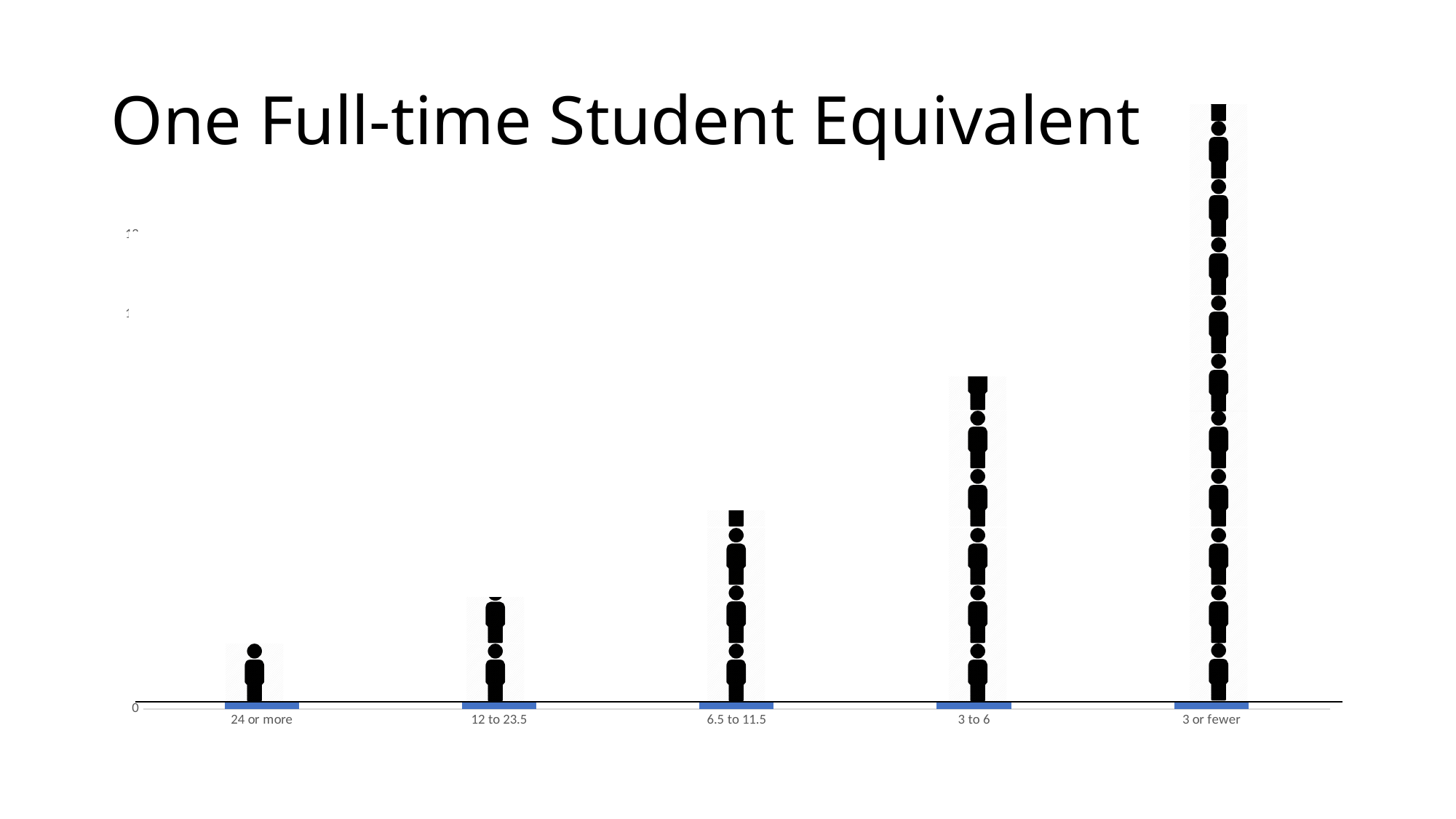
Which category has the highest value in the chart? 3 or fewer Do the values rise or fall moving from left to right along the x axis? rise How many categories are shown on the x axis of the chart? 5 Which category has the second-highest value in the chart? 3 to 6 What is the title of the chart on the slide? One Full-time Student Equivalent Which is larger, the value for '3 to 6' or the value for '6.5 to 11.5'? 3 to 6 Which is larger, the value for '24 or more' or the value for '12 to 23.5'? 12 to 23.5 Which category has the lowest value in the chart? 24 or more What is the label of the leftmost category on the x axis? 24 or more What kind of chart is shown on the slide? bar chart Which is larger, the value for '3 or fewer' or the value for '3 to 6'? 3 or fewer